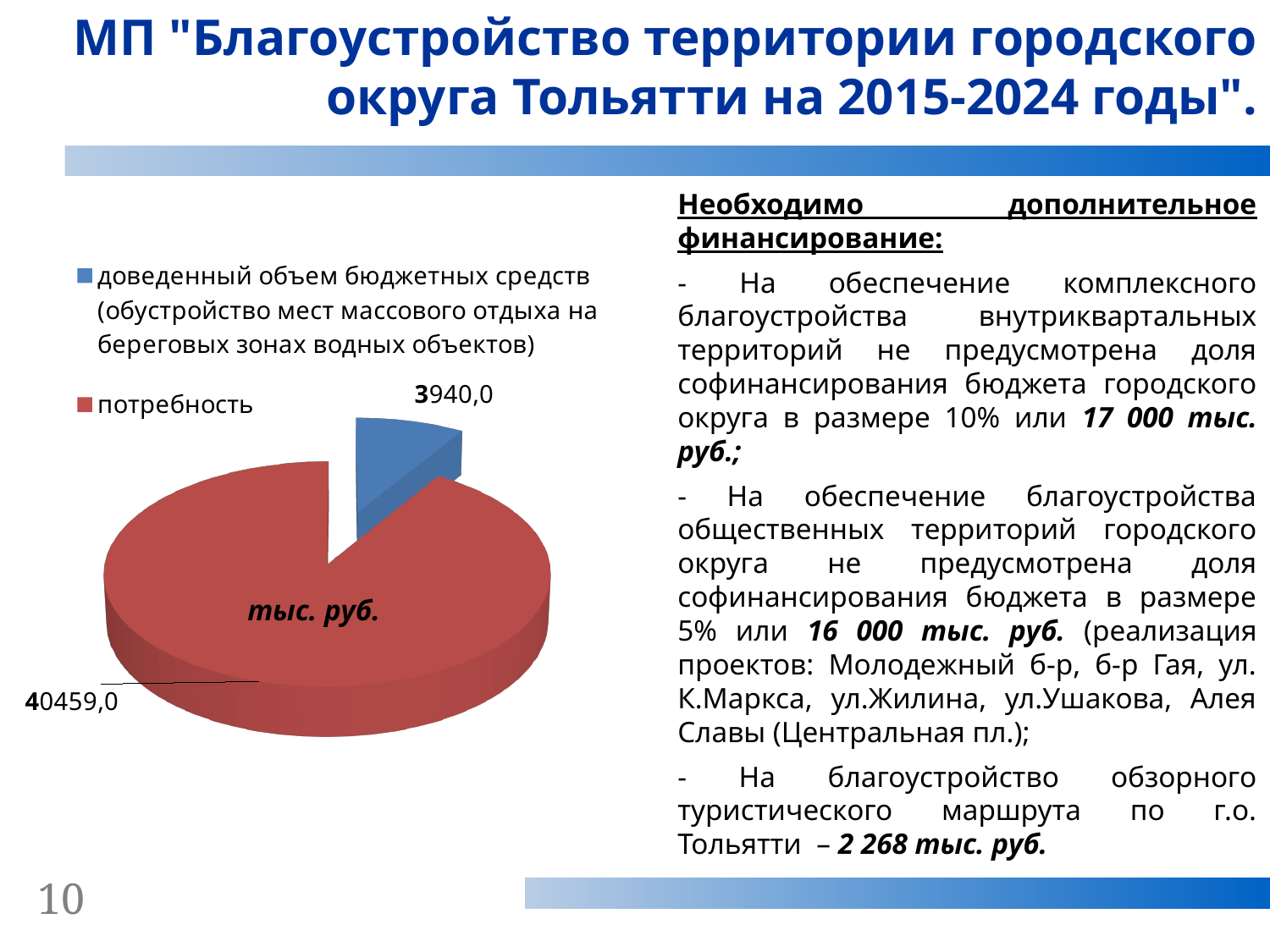
What colour is the "потребность" slice in the pie chart? red Which category has the smallest slice in the pie chart? доведенный объем бюджетных средств (обустройство мест массового отдыха на береговых зонах водных объектов) What is the difference between the "потребность" value and the "доведенный объем бюджетных средств" value in the pie chart? 36519,0 How many slices does the pie chart have? 2 What unit label is printed inside the pie chart? тыс. руб. What is the value of the "потребность" slice in the pie chart? 40459,0 What type of chart is shown on the slide? pie chart What is the value of the "доведенный объем бюджетных средств" slice in the pie chart? 3940,0 Which is larger in the pie chart: "потребность" or "доведенный объем бюджетных средств"? потребность Which category has the largest slice in the pie chart? потребность What is the total of the two values shown in the pie chart? 44399,0 How many entries does the legend of the pie chart list? 2